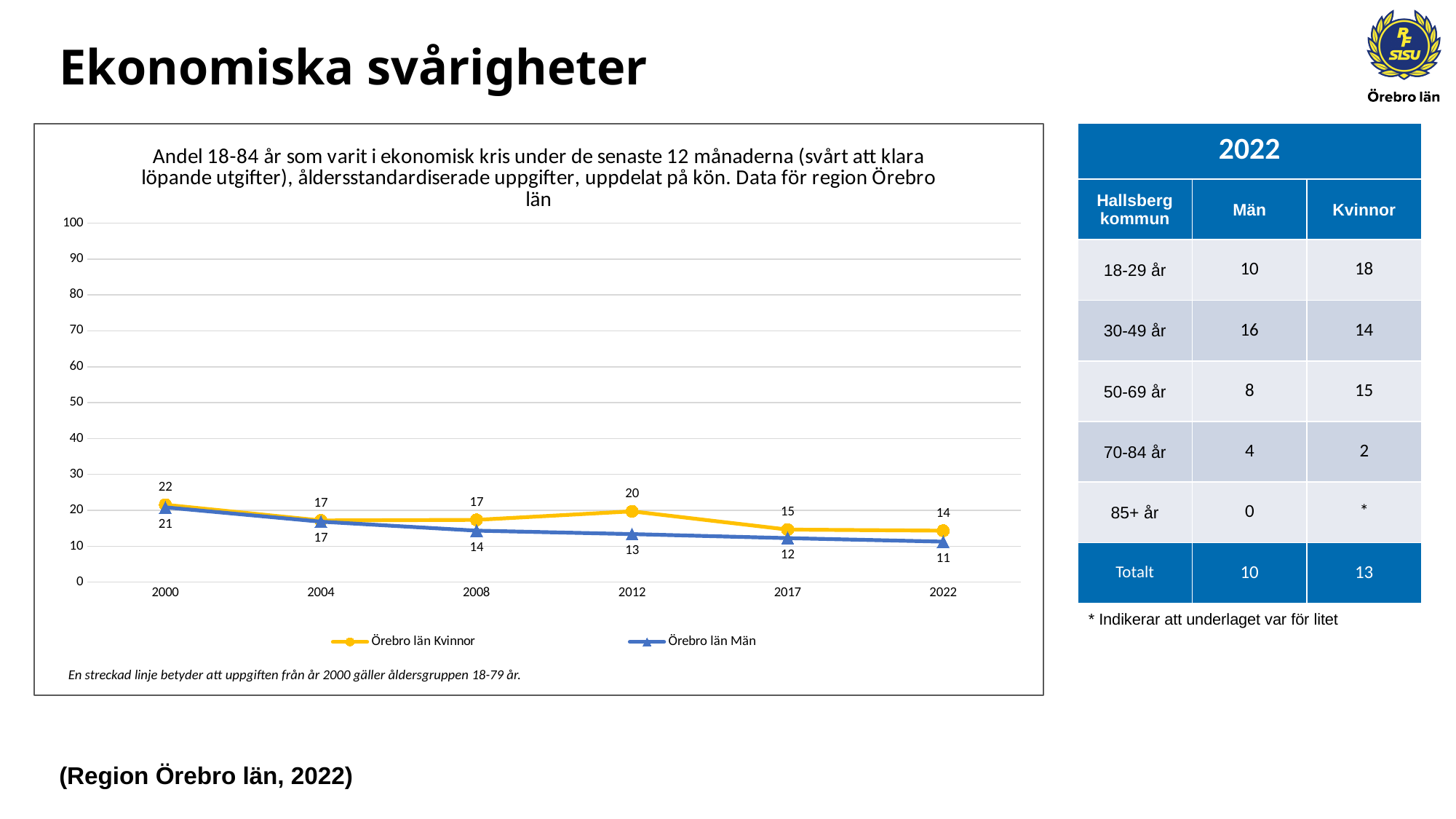
What is the value for Örebro län Män in 2000? 21 In which year is the value for Örebro län Män lowest? 2022 What type of chart is shown on the slide? line chart What is the value for Örebro län Män in 2022? 11 How many years are plotted along the x axis of the chart? 6 What is the value for Örebro län Kvinnor in 2012? 20 Does the value for Örebro län Män rise or fall from 2000 to 2022? fall Which colour is used for the Örebro län Kvinnor line in the chart? yellow In which year is the value for Örebro län Kvinnor highest? 2000 Which series has the larger value in 2008, Örebro län Kvinnor or Örebro län Män? Örebro län Kvinnor What is the difference between Örebro län Kvinnor and Örebro län Män in 2012? 7 How many series does the chart legend list? 2